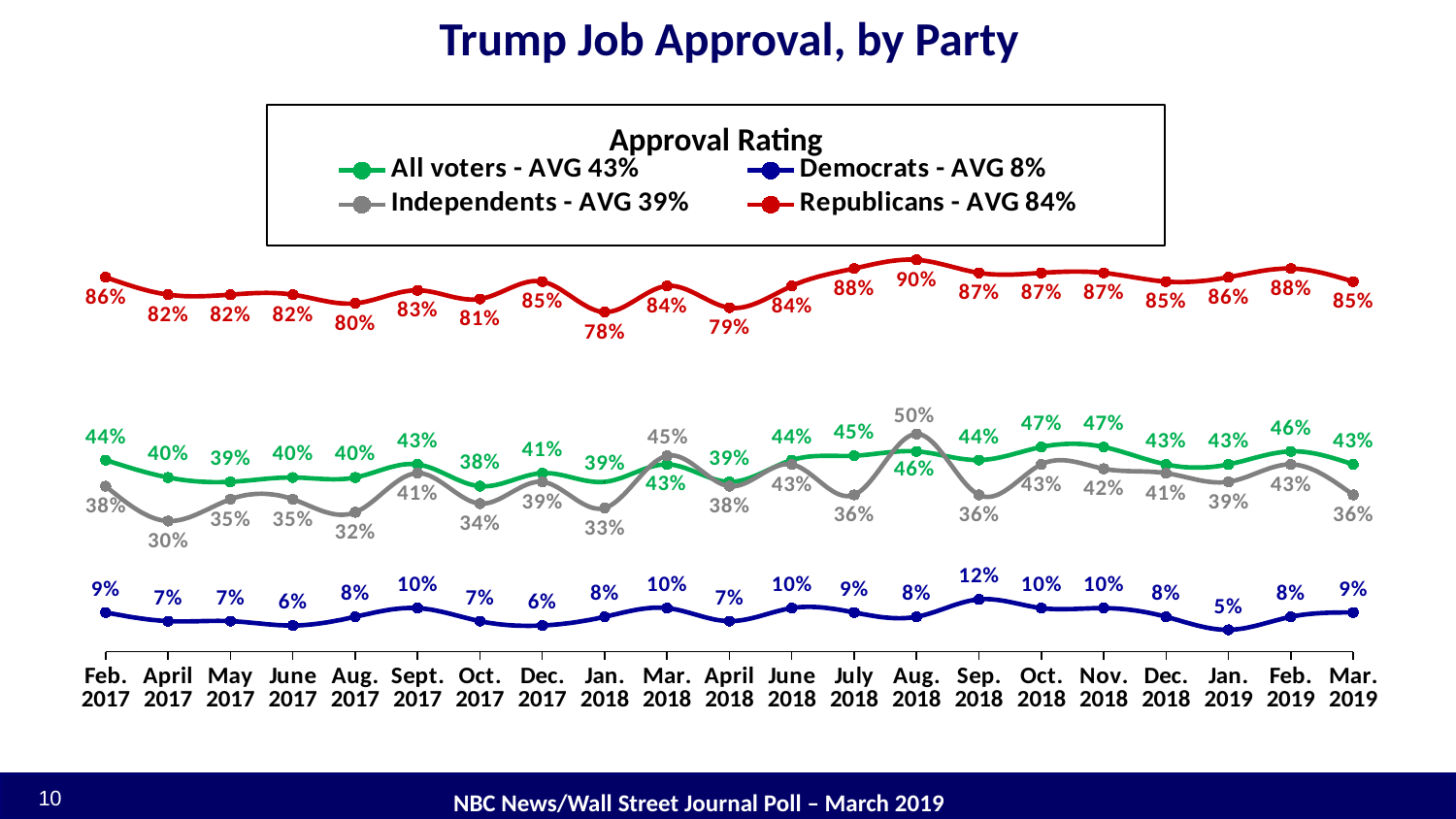
What is the average approval rating for Independents shown in the legend? 39% What is the approval rating among Republicans in Aug. 2018? 90% In which month is the Independents approval rating highest? Aug. 2018 What is the approval rating among All voters in Mar. 2019? 43% What is the difference between the Republican and Democrat approval ratings in Mar. 2019? 76 percentage points In which month is the Democrats approval rating lowest? Jan. 2019 What is the approval rating among Independents in Feb. 2017? 38% What is the approval rating among Democrats in Sep. 2018? 12% In which month is the Republican approval rating lowest? Jan. 2018 Which is higher in Mar. 2018: the approval rating among Independents or among All voters? Independents How many series does the legend list? 4 How many time points are plotted on the x axis? 21